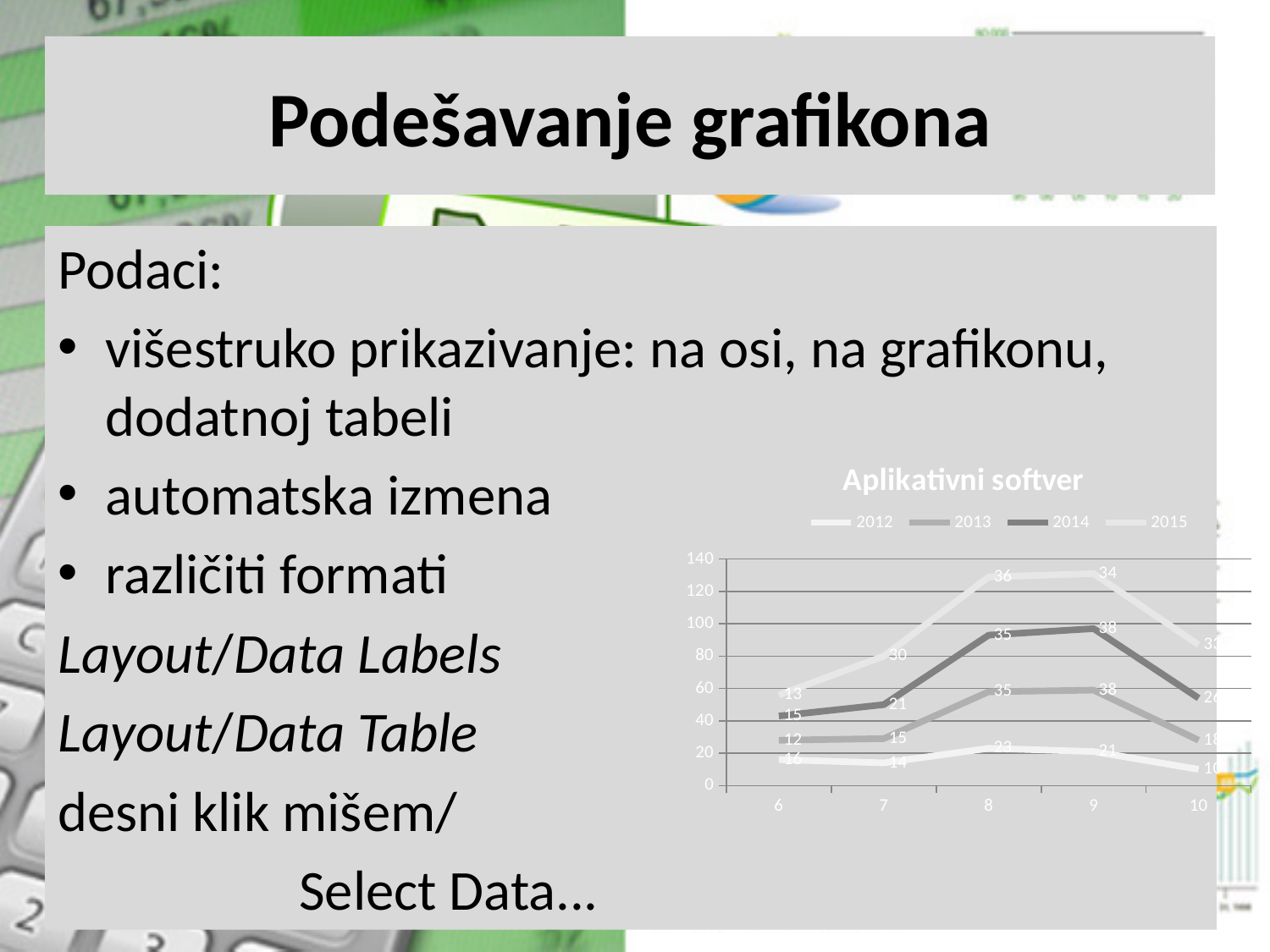
How many series does the legend of the chart list? 4 At which category does the 2013 series have its lowest value? 6 What kind of chart is shown on the slide? line chart At which category does the 2012 series reach its highest value? 8 What is the difference between the 2014 series values at category 9 and category 7? 17 Does the 2015 series rise or fall from category 6 to category 8? rise How many categories are shown on the x axis of the chart? 5 At category 7, which series has the larger value, 2015 or 2013? 2015 What is the title of the chart on the slide? Aplikativni softver What is the value of the 2012 series at category 6? 16 What is the value of the 2015 series at category 8? 36 What is the value of the 2014 series at category 9? 38